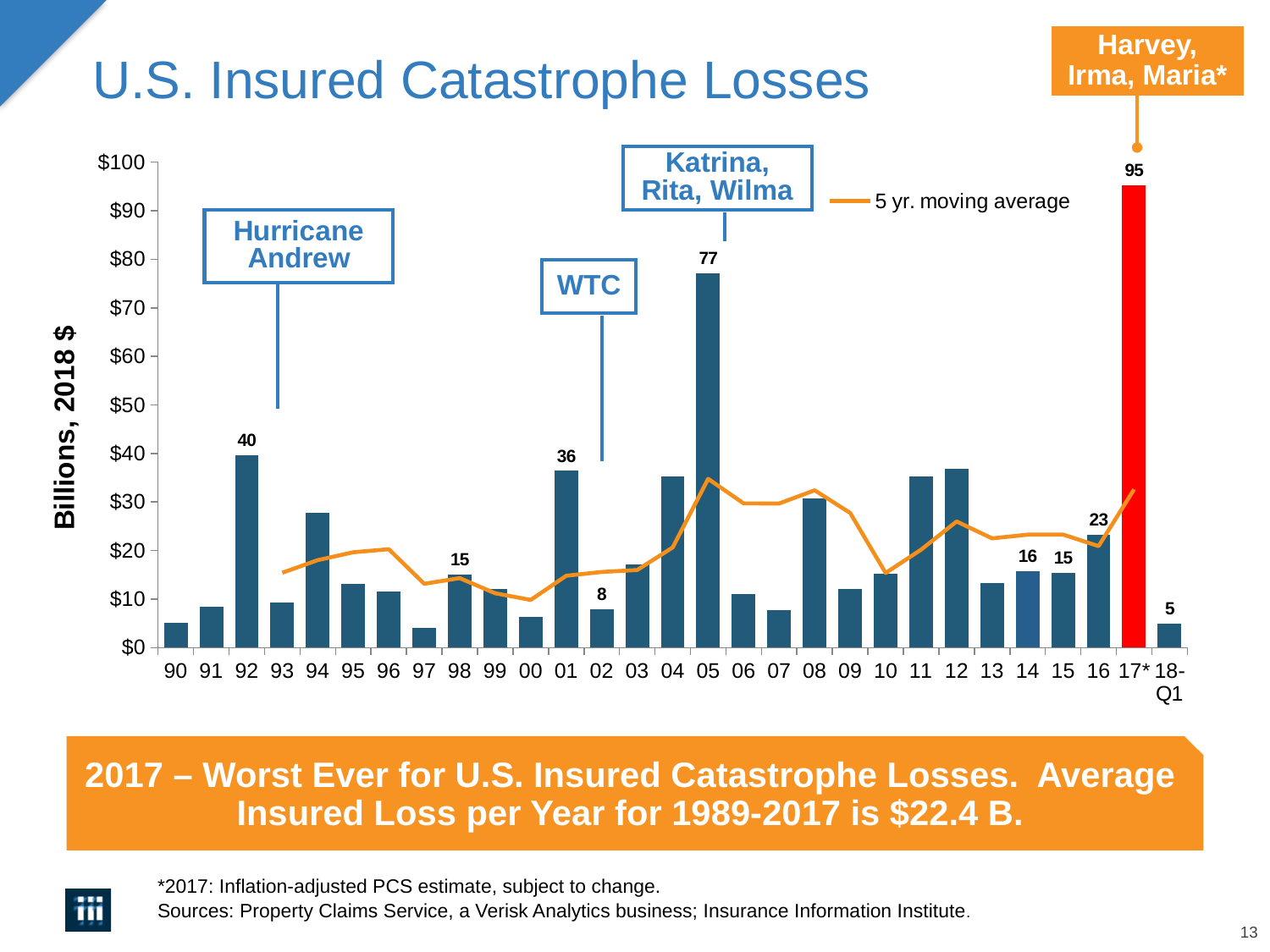
What is the value for 18-Q1 in the chart? 5 How many categories are shown on the x axis of the chart? 29 Which year has the highest insured catastrophe losses in the chart? 17* What does the orange line in the chart represent? 5 yr. moving average What is the value for 17* in the U.S. Insured Catastrophe Losses chart? 95 What is the value for 92 in the chart? 40 Which is larger, the value for 92 or the value for 01? 92 What is the difference between the values for 17* and 05? 18 What is the value for 05 in the chart? 77 What is the difference between the values for 16 and 15? 8 What kind of chart is shown on the slide? Bar chart with a line Is the value for 11 greater or less than $30? greater